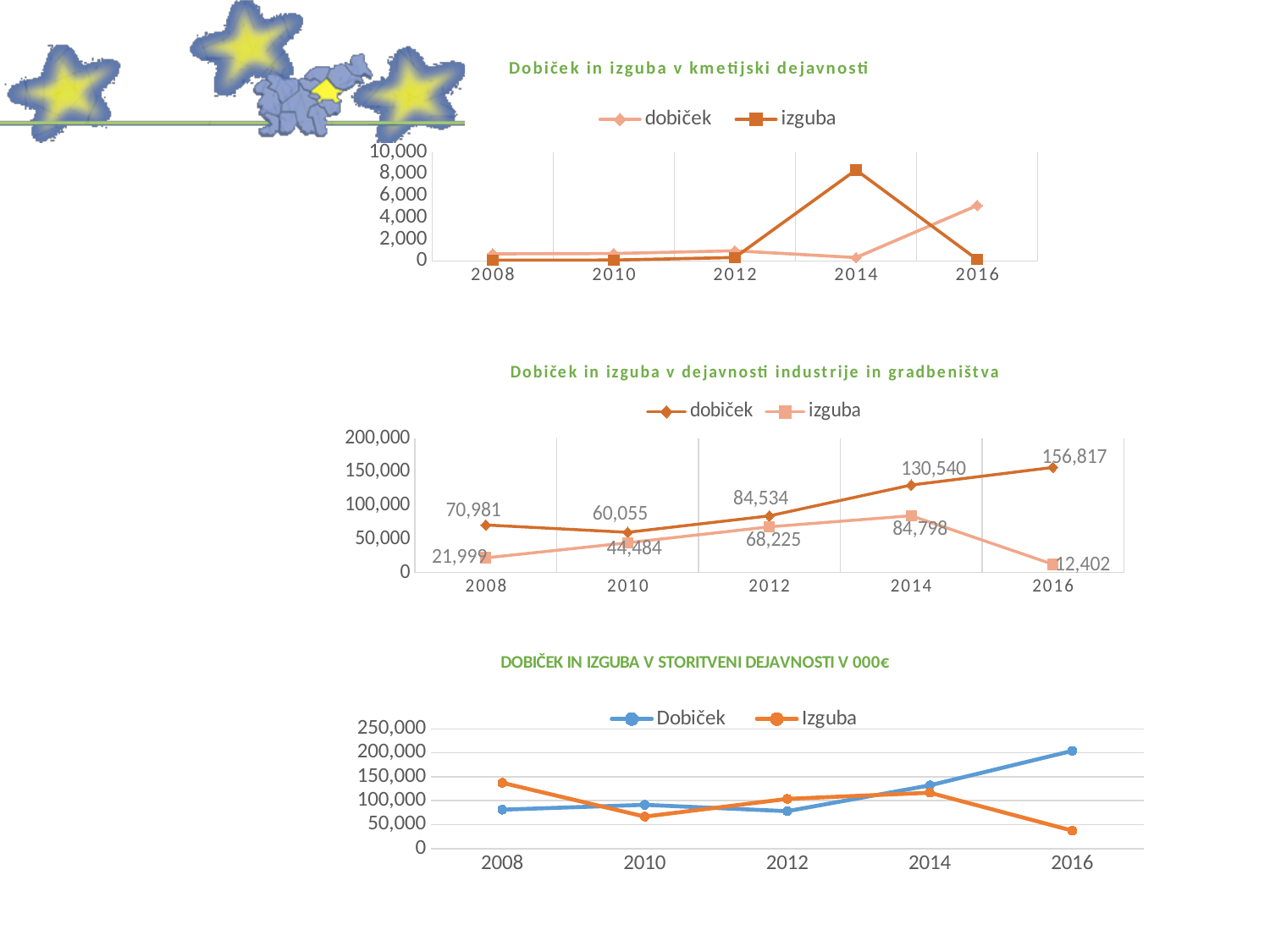
In the bottom chart titled "DOBIČEK IN IZGUBA V STORITVENI DEJAVNOSTI V 000€", is the Dobiček value for 2016 greater or less than 150,000? greater In the bottom chart titled "DOBIČEK IN IZGUBA V STORITVENI DEJAVNOSTI V 000€", which is larger in 2008, Dobiček or Izguba? Izguba In the chart titled "Dobiček in izguba v dejavnosti industrije in gradbeništva", does the dobiček series rise or fall from 2010 to 2016? rise In the chart titled "Dobiček in izguba v dejavnosti industrije in gradbeništva", which year has the highest izguba value? 2014 In the chart titled "Dobiček in izguba v dejavnosti industrije in gradbeništva", what is the dobiček value for 2016? 156,817 In the chart titled "Dobiček in izguba v dejavnosti industrije in gradbeništva", what is the difference between dobiček and izguba in 2016? 144,415 How many years are shown on the x axis of the top chart titled "Dobiček in izguba v kmetijski dejavnosti"? 5 What kind of chart is the bottom chart titled "DOBIČEK IN IZGUBA V STORITVENI DEJAVNOSTI V 000€"? line chart In the chart titled "Dobiček in izguba v dejavnosti industrije in gradbeništva", which is larger in 2012, dobiček or izguba? dobiček In the chart titled "Dobiček in izguba v dejavnosti industrije in gradbeništva", what is the izguba value for 2010? 44,484 In the chart titled "Dobiček in izguba v dejavnosti industrije in gradbeništva", which year has the lowest dobiček value? 2010 In the top chart titled "Dobiček in izguba v kmetijski dejavnosti", is the izguba value for 2014 greater or less than 6,000? greater